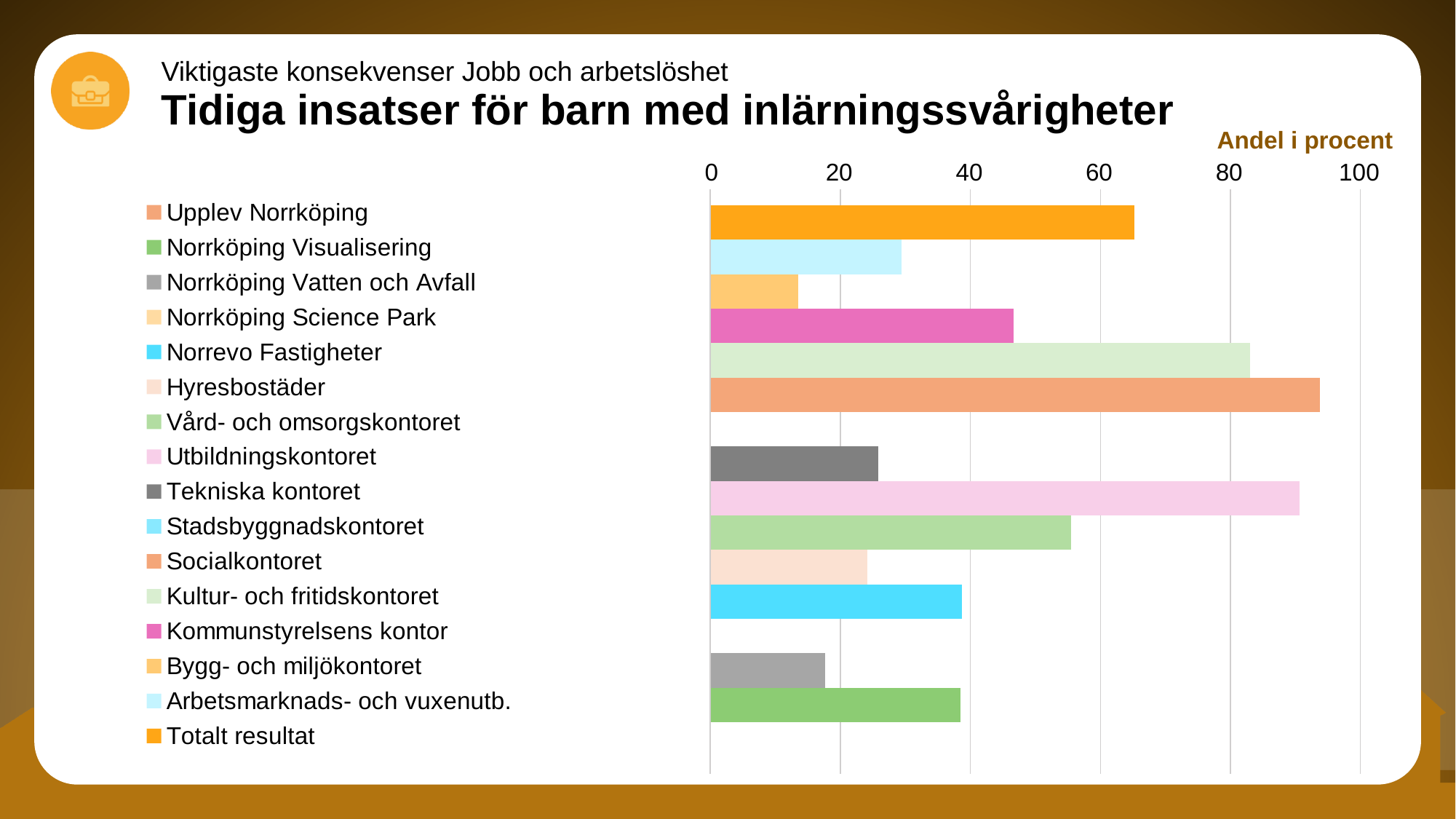
What is the highest value shown on the horizontal axis of the chart? 100 How many entries does the chart legend list? 16 Which has the larger value, Utbildningskontoret or Tekniska kontoret? Utbildningskontoret Is the value for Vård- och omsorgskontoret greater or less than 40? greater Is the value for Hyresbostäder greater or less than 40? less Which has the larger value, Socialkontoret or Totalt resultat? Socialkontoret Is the value for Socialkontoret greater or less than 80? greater What is the label shown above the horizontal axis of the chart? Andel i procent What kind of chart is shown on the slide? bar chart